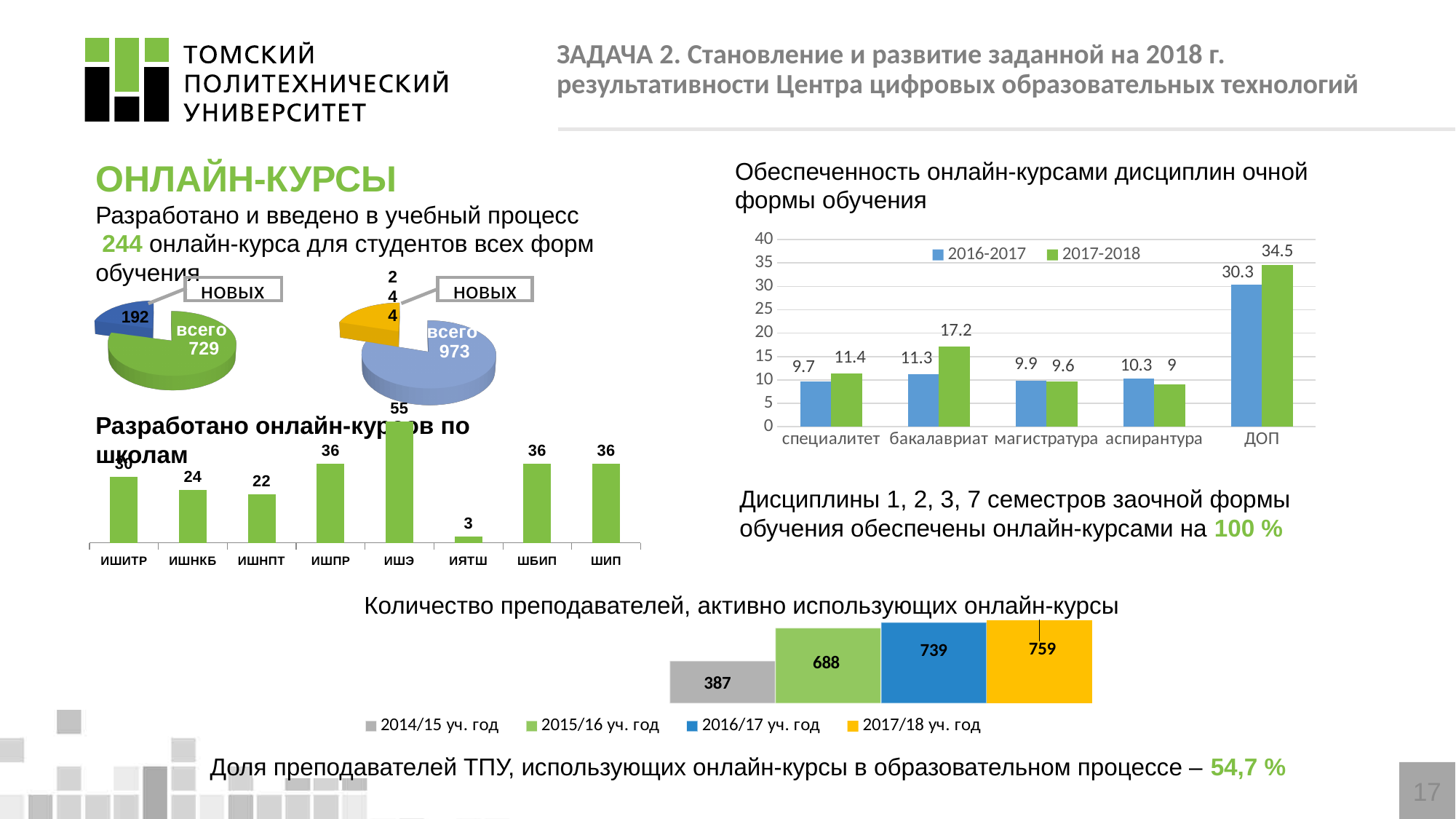
In the chart 'Обеспеченность онлайн-курсами дисциплин очной формы обучения', how many series does the legend list? 2 In the chart 'Количество преподавателей, активно использующих онлайн-курсы', what is the difference between 2015/16 уч. год and 2014/15 уч. год? 301 In the chart 'Обеспеченность онлайн-курсами дисциплин очной формы обучения', what is the difference between the 2017-2018 and 2016-2017 values for бакалавриат? 5.9 In the chart 'Разработано онлайн-курсов по школам', what is the value for ИШНКБ? 24 In the chart 'Обеспеченность онлайн-курсами дисциплин очной формы обучения', what is the value for бакалавриат in 2016-2017? 11.3 In the chart 'Разработано онлайн-курсов по школам', which school has the highest value? ИШЭ In the chart 'Обеспеченность онлайн-курсами дисциплин очной формы обучения', what is the value for ДОП in 2017-2018? 34.5 In the chart 'Количество преподавателей, активно использующих онлайн-курсы', what is the value for 2017/18 уч. год? 759 In the chart 'Обеспеченность онлайн-курсами дисциплин очной формы обучения', is the 2016-2017 value for аспирантура larger or smaller than the 2017-2018 value? larger In the chart 'Обеспеченность онлайн-курсами дисциплин очной формы обучения', which category has the highest value in 2017-2018? ДОП In the chart 'Разработано онлайн-курсов по школам', which school has the lowest value? ИЯТШ In the chart 'Разработано онлайн-курсов по школам', how many schools are shown? 8